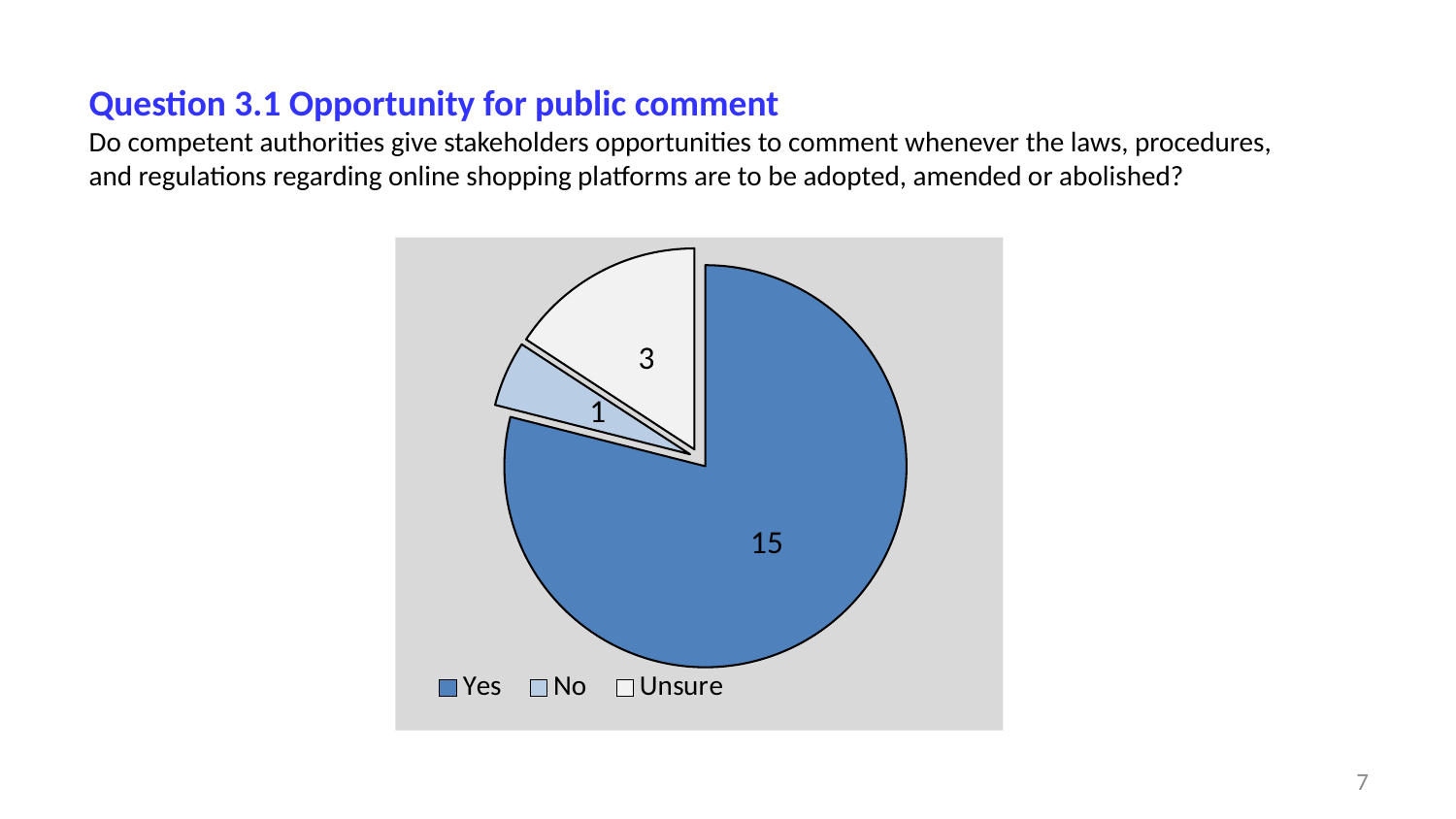
How many responses are in the Unsure slice? 3 What is the difference between the Yes and Unsure counts? 12 How many entries does the legend list? 3 How many responses are in the No slice? 1 Which is larger, the Unsure slice or the No slice? Unsure Which response category has the smallest slice? No How many slices does the pie chart have? 3 What colour is the Yes slice? blue What kind of chart is shown on the slide? pie chart What is the total number of responses shown in the pie chart? 19 How many responses are in the Yes slice? 15 Which response category has the largest slice? Yes